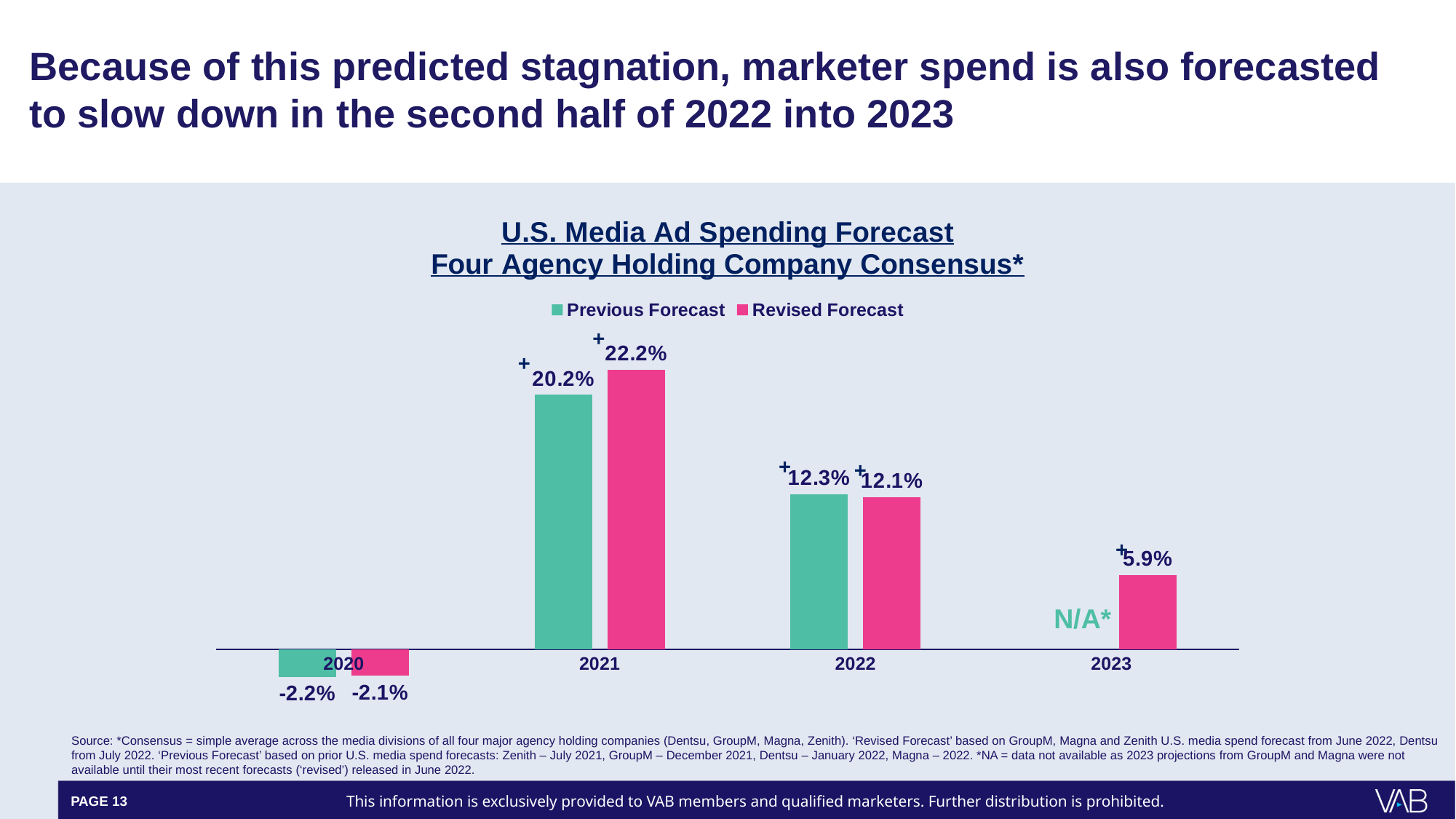
What is the Previous Forecast value for 2020? -2.2% What is the Revised Forecast value for 2023? +5.9% Which year has the lowest Revised Forecast value? 2020 What kind of chart is shown on the slide? Bar chart What is the Previous Forecast value for 2022? +12.3% How many series does the legend list? 2 By how many percentage points does the Revised Forecast for 2021 exceed the Previous Forecast for 2021? 2.0 percentage points What is shown in place of the Previous Forecast value for 2023? N/A* For 2022, which is larger: the Previous Forecast or the Revised Forecast? Previous Forecast What is the Revised Forecast value for 2021? +22.2% How many years are shown on the x axis? 4 Which year has the highest Revised Forecast value? 2021